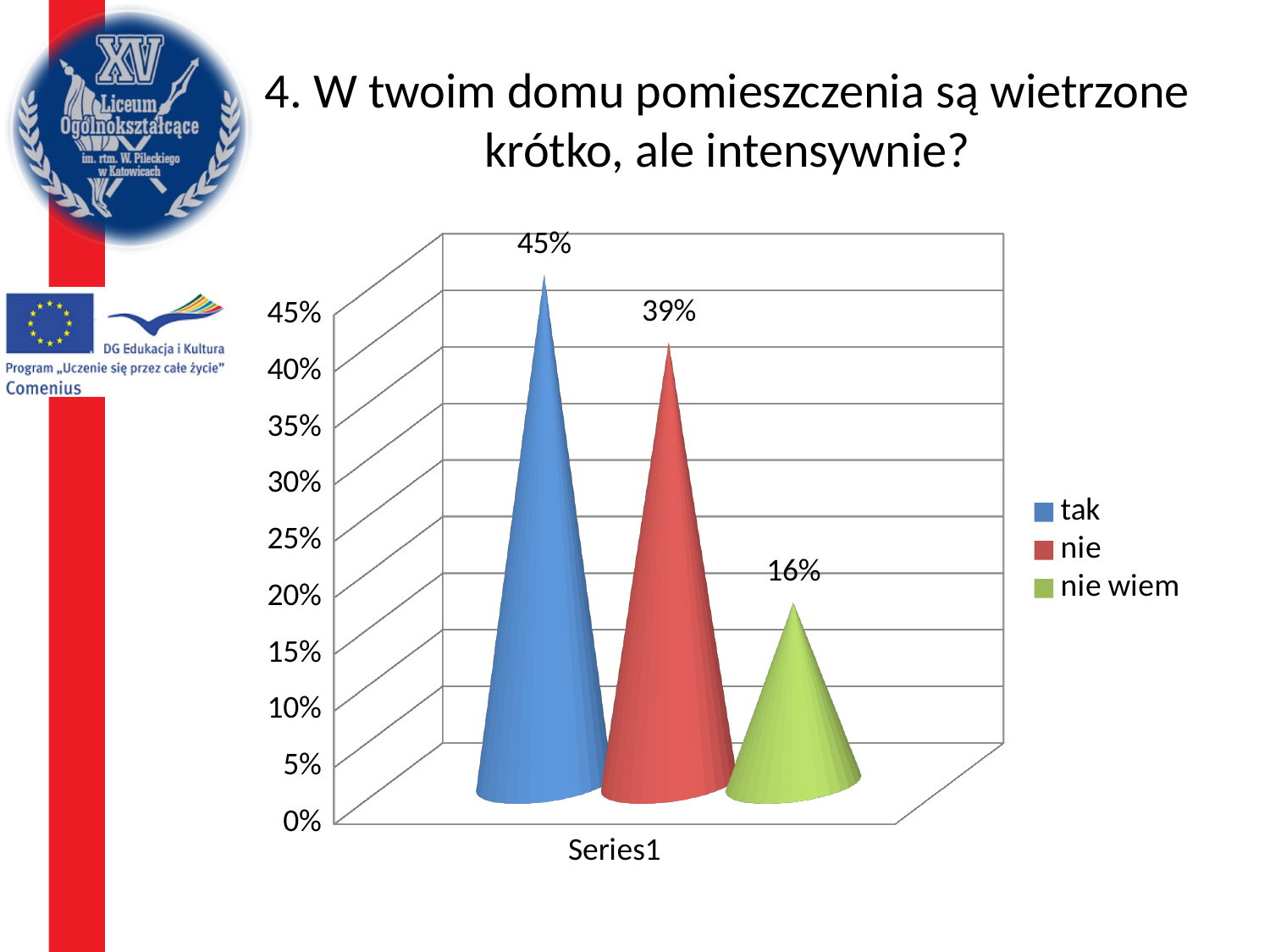
What is the difference between the values for "tak" and "nie"? 6% Which is larger, the value for "nie" or the value for "nie wiem"? nie What colour is the bar for "nie wiem"? green Which category has the highest value? tak What is the value for "nie"? 39% Is the value for "nie wiem" greater or less than 20%? less Which category has the lowest value? nie wiem How many series does the legend list? 3 What is the difference between the values for "nie" and "nie wiem"? 23% What is the value for "tak"? 45% What is the value for "nie wiem"? 16% What kind of chart is shown on the slide? bar chart